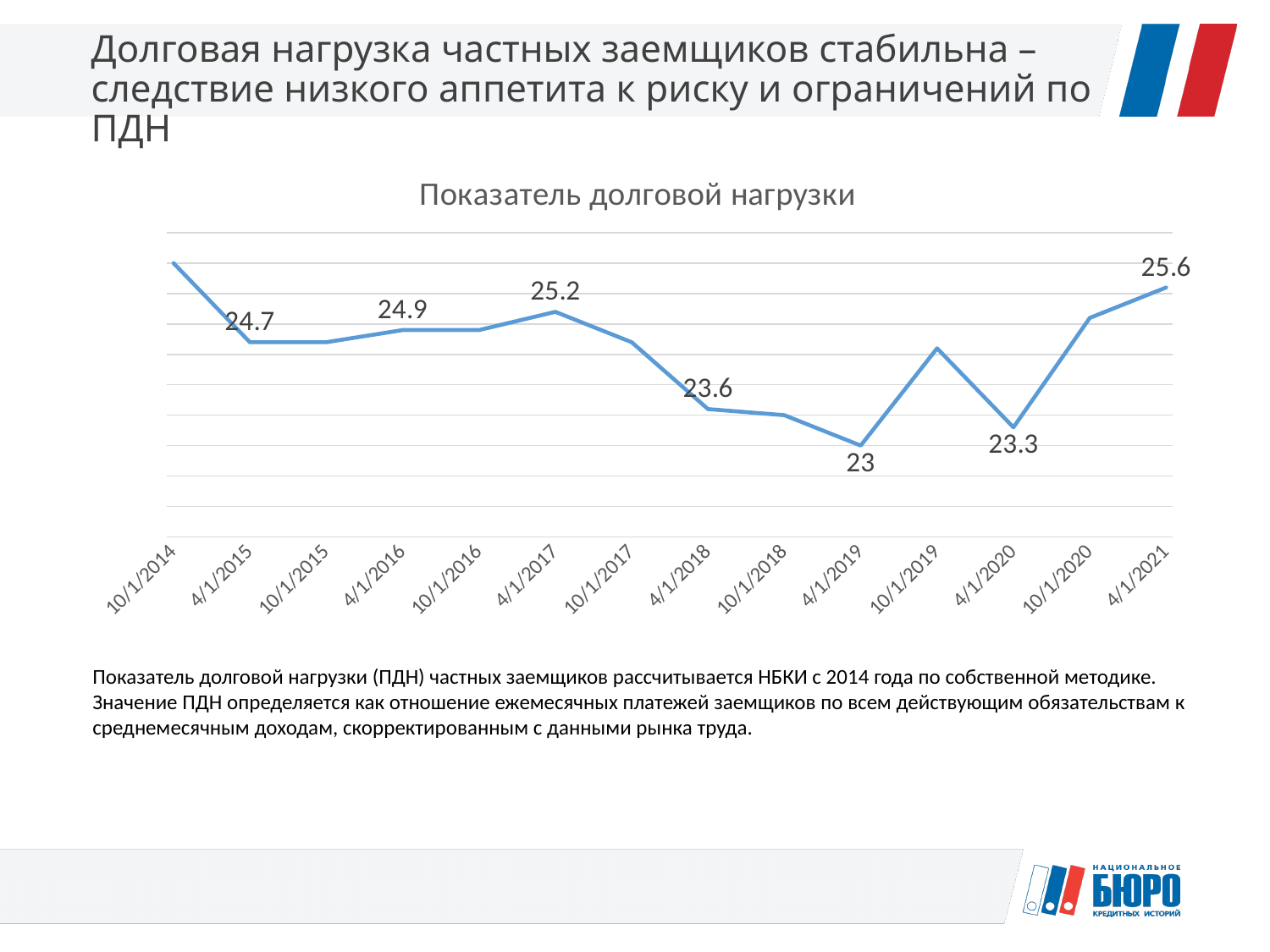
Does the value rise or fall between 4/1/2020 and 4/1/2021? Rise What kind of chart is shown on the slide? Line chart What is the value shown for 4/1/2020? 23.3 What is the difference between the values at 4/1/2017 and 4/1/2018? 1.6 What is the value of the debt burden indicator at 4/1/2015? 24.7 What is the value shown for 4/1/2021? 25.6 What is the value shown for 4/1/2017? 25.2 Which is larger, the value at 4/1/2016 or the value at 4/1/2020? 4/1/2016 What is the difference between the values at 4/1/2021 and 4/1/2019? 2.6 Which date has the lowest value on the chart? 4/1/2019 How many data points are plotted on the chart? 14 What is the value shown for 4/1/2019? 23